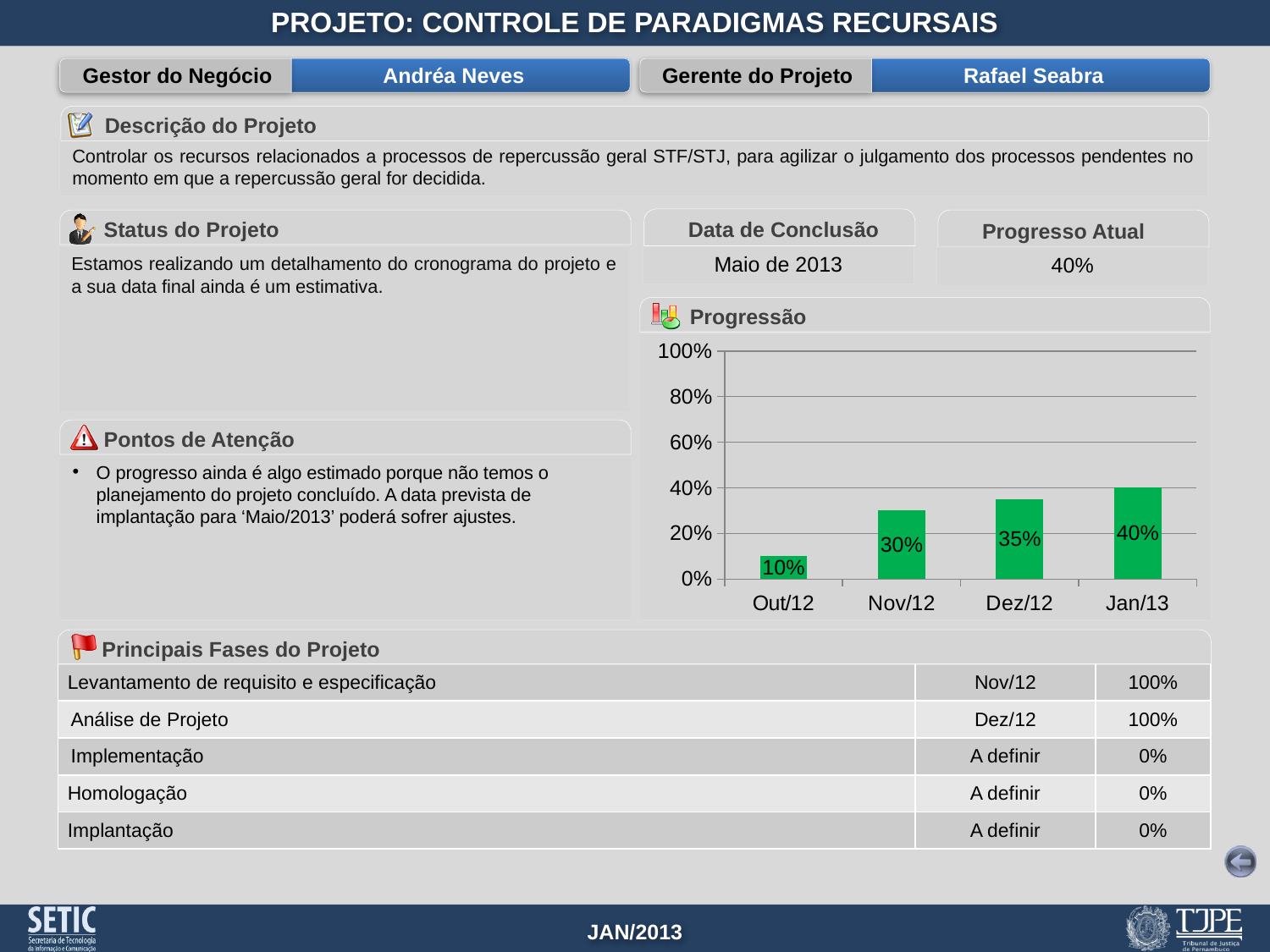
How many months are plotted in the Progressão chart? 4 What is the value for Nov/12 in the Progressão chart? 30% Do the values in the Progressão chart rise or fall from Out/12 to Jan/13? Rise Which month has the highest value in the Progressão chart? Jan/13 Which is larger in the Progressão chart, the value for Nov/12 or the value for Dez/12? Dez/12 What is the difference between the values for Jan/13 and Out/12 in the Progressão chart? 30% What is the difference between the values for Dez/12 and Nov/12 in the Progressão chart? 5% What is the value for Dez/12 in the Progressão chart? 35% What is the value for Out/12 in the Progressão chart? 10% Which month has the lowest value in the Progressão chart? Out/12 What is the value for Jan/13 in the Progressão chart? 40% What kind of chart is the Progressão chart? Bar chart